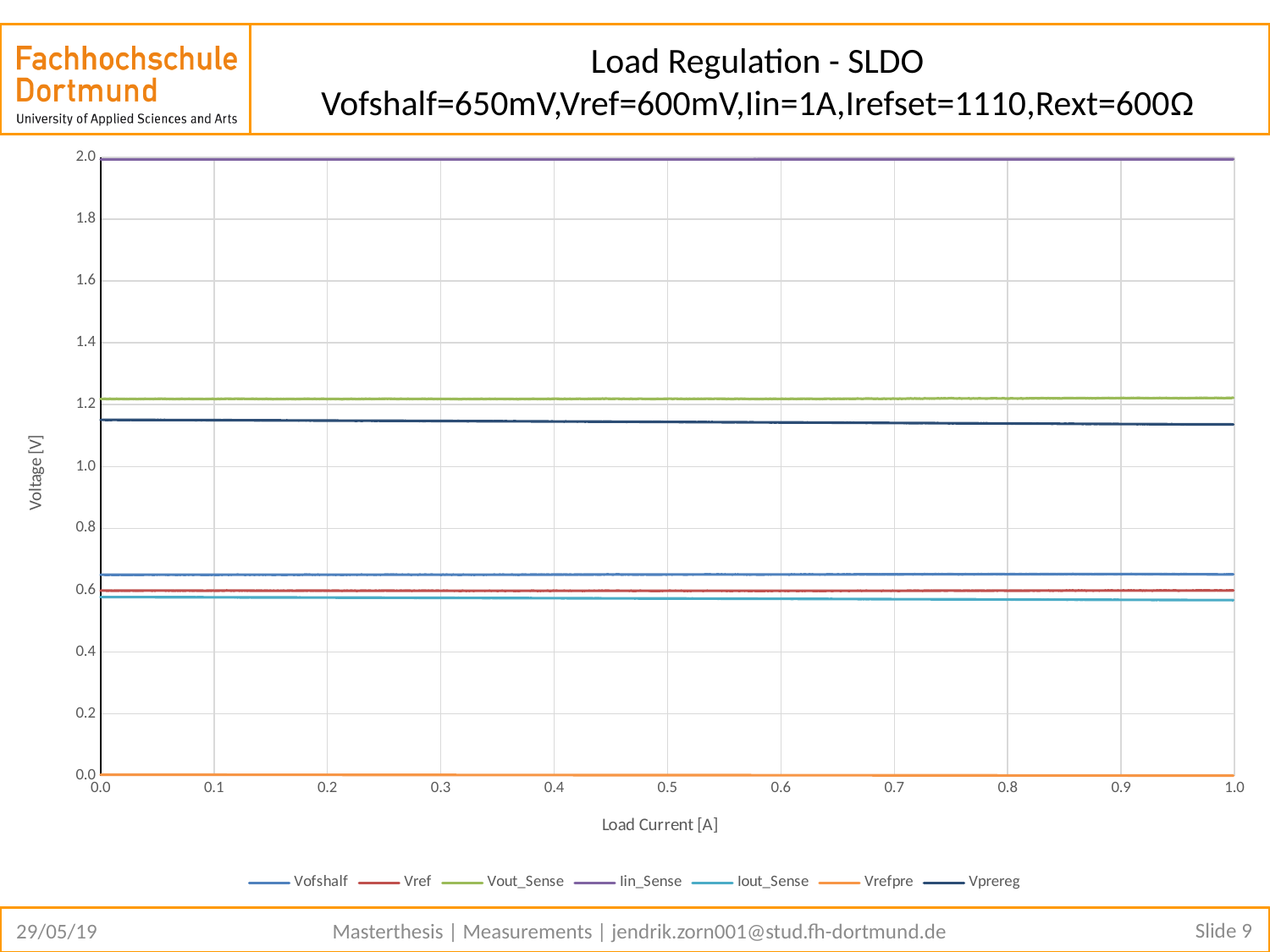
Is the value for Vrefpre greater or less than 0.2 V? less Which series has the lowest voltage across the load current range? Vrefpre What is the label of the x axis? Load Current [A] Is the value for Iin_Sense greater or less than 1.8? greater Which series is higher, Vofshalf or Vref? Vofshalf Is the value for Vprereg greater or less than 1.2 V? less How many series does the legend list? 7 What kind of chart is shown on the slide? line chart Does the Vprereg line rise or fall as load current increases from 0.0 to 1.0 A? fall Which series is higher, Vout_Sense or Vprereg? Vout_Sense Which series has the highest voltage across the load current range? Iin_Sense